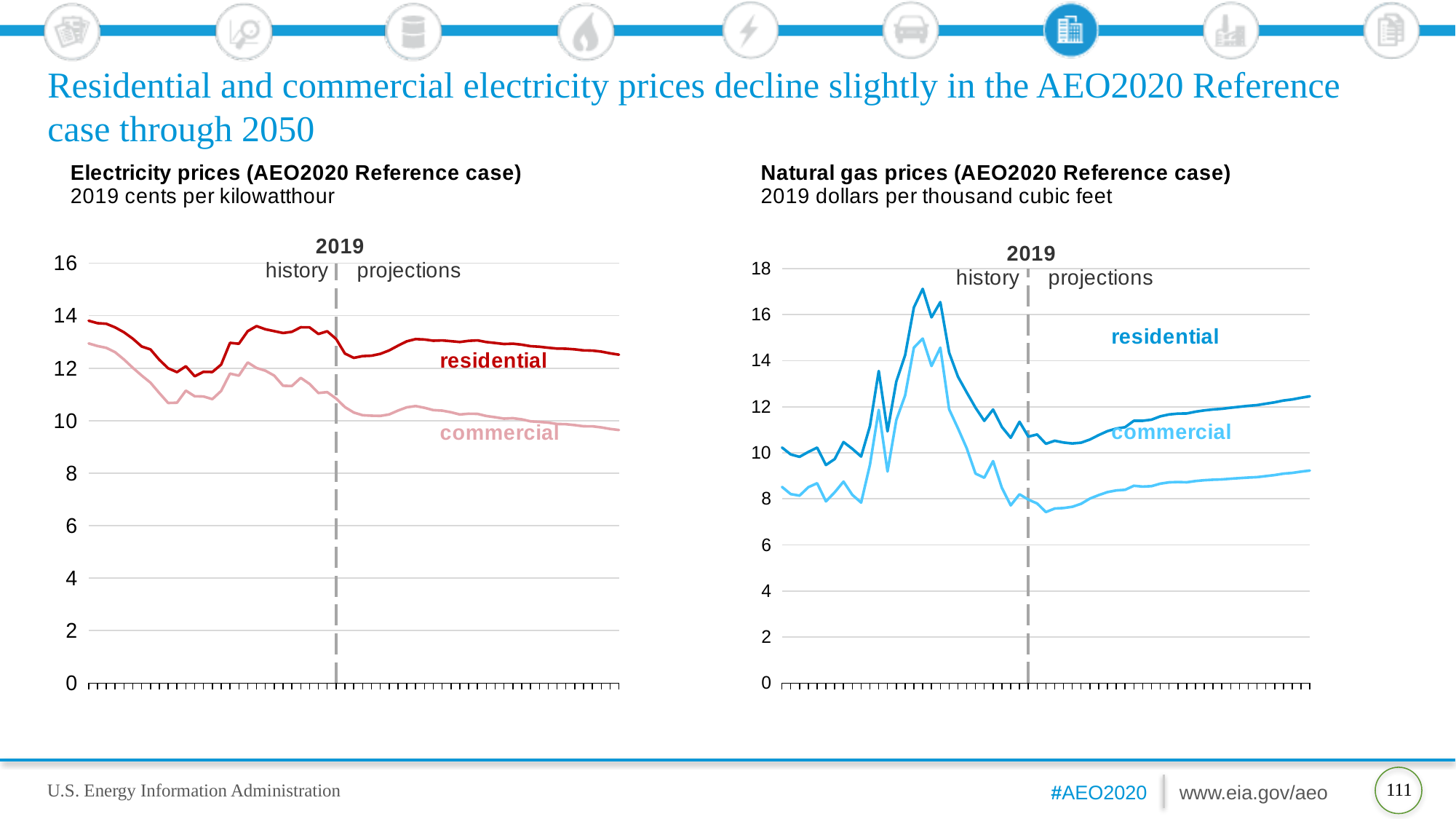
On the Electricity prices chart, which series is higher throughout, residential or commercial? residential How many series are plotted on the Natural gas prices (AEO2020 Reference case) chart? 2 On the Electricity prices chart, do residential prices rise or fall over the projection period? fall On the Electricity prices chart, is the residential value at the end of the projection period greater or less than 10? greater On the Natural gas prices chart, is the peak commercial value greater or less than 16? less On the Natural gas prices chart, do residential prices rise or fall over the projection period? rise What year does the dashed vertical line separating history from projections mark on the Electricity prices chart? 2019 On the Natural gas prices chart, is the commercial value at the end of the projection period greater or less than 10? less What unit is used on the Natural gas prices (AEO2020 Reference case) chart? 2019 dollars per thousand cubic feet What type of chart is the Electricity prices (AEO2020 Reference case) chart? line chart